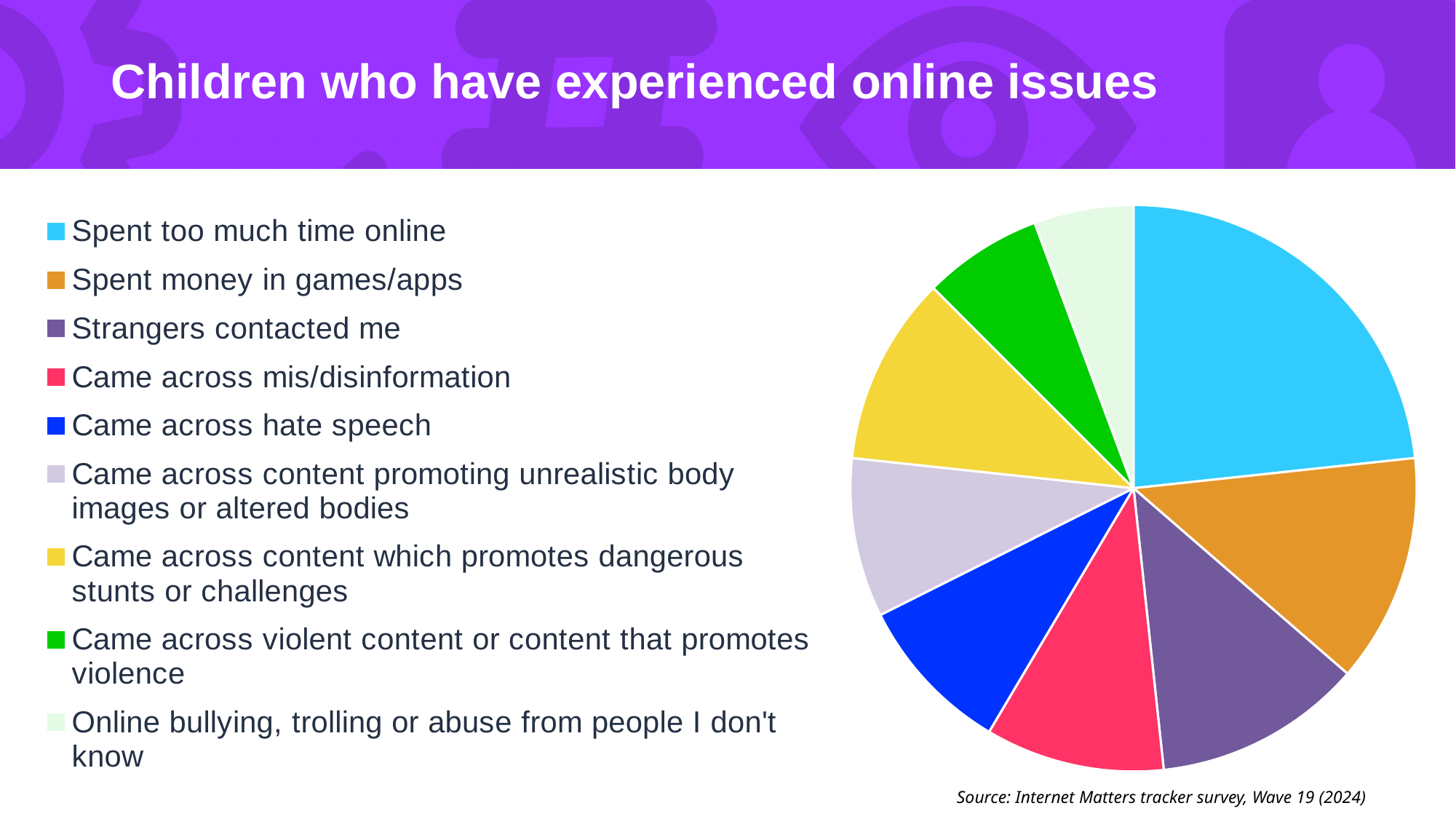
Which slice is larger: "Came across hate speech" or "Spent too much time online"? Spent too much time online What kind of chart is shown on the slide? Pie chart What source is cited for the pie chart data? Internet Matters tracker survey, Wave 19 (2024) What is the title of the slide containing the pie chart? Children who have experienced online issues Which slice is larger: "Came across content which promotes dangerous stunts or challenges" or "Online bullying, trolling or abuse from people I don't know"? Came across content which promotes dangerous stunts or challenges How many categories (slices) does the pie chart have? 9 Which slice is larger: "Spent too much time online" or "Spent money in games/apps"? Spent too much time online Which category has the largest slice of the pie chart? Spent too much time online What colour is the slice for "Came across mis/disinformation"? Pink/red